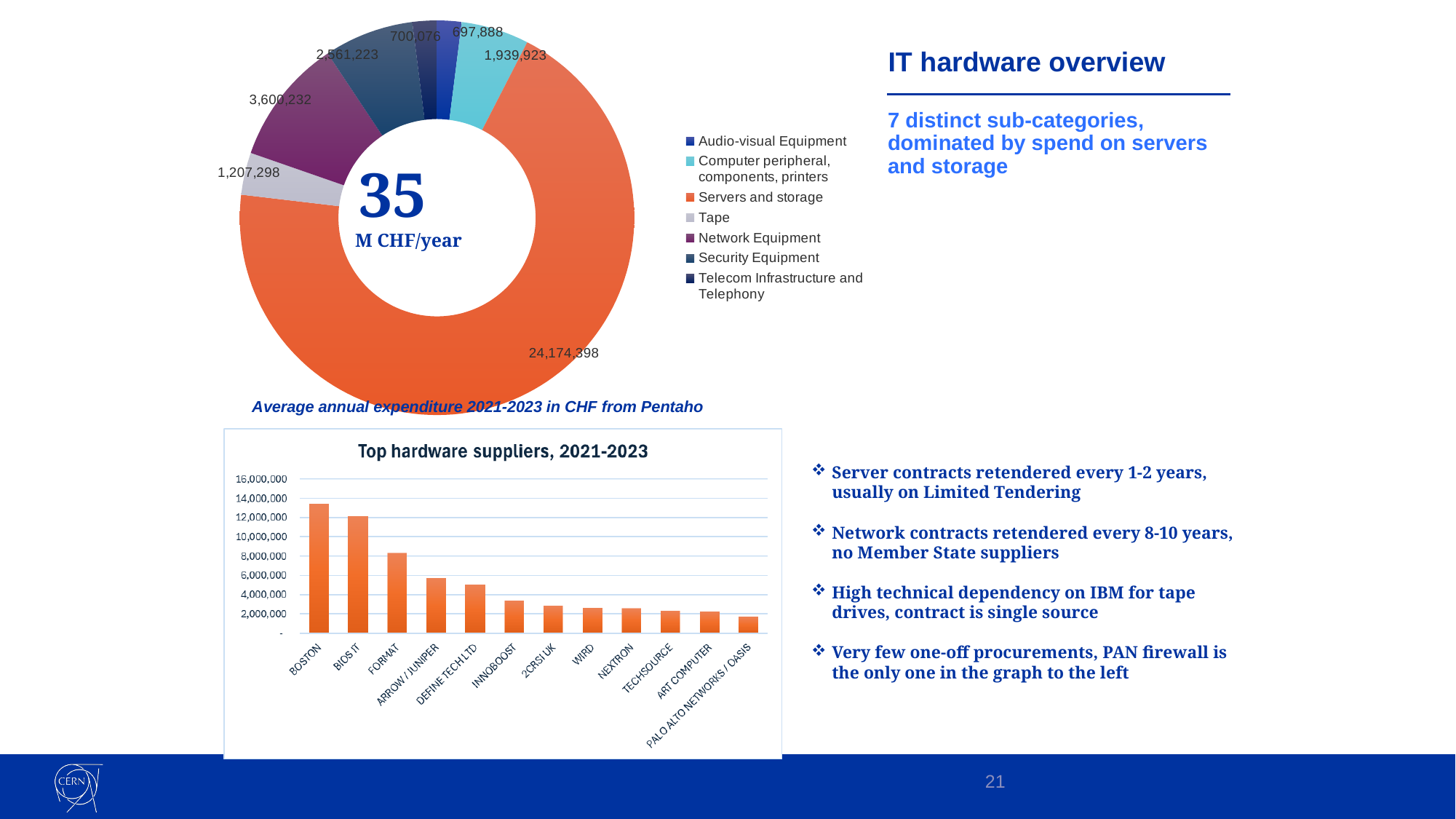
In the 'Top hardware suppliers, 2021-2023' chart, which supplier has the highest value? BOSTON In the average annual expenditure pie chart, what is the difference between Network Equipment and Security Equipment? 1,039,009 In the average annual expenditure pie chart, which is larger: Computer peripheral, components, printers or Tape? Computer peripheral, components, printers In the 'Top hardware suppliers, 2021-2023' chart, do the values rise or fall from left to right? fall In the average annual expenditure pie chart, which category has the largest slice? Servers and storage What kind of chart is the top chart showing average annual expenditure 2021-2023? doughnut chart In the 'Top hardware suppliers, 2021-2023' chart, is the value for BOSTON greater or less than 12,000,000? greater In the average annual expenditure pie chart, what is the value for Tape? 1,207,298 What kind of chart is 'Top hardware suppliers, 2021-2023'? bar chart In the average annual expenditure pie chart, what is the value for Servers and storage? 24,174,398 How many categories does the average annual expenditure pie chart show? 7 In the average annual expenditure pie chart, what is the value for Network Equipment? 3,600,232